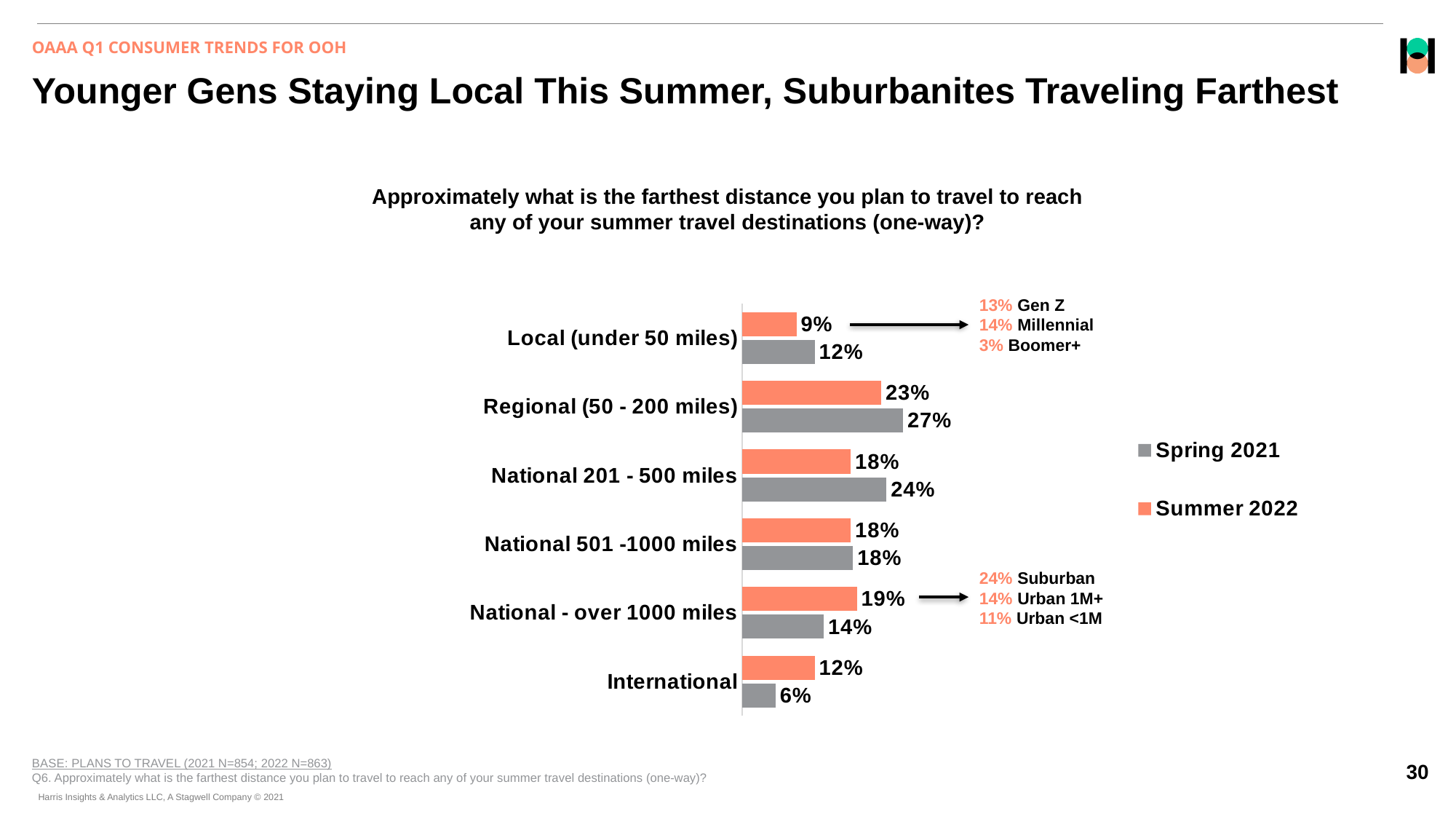
What is the difference between the Spring 2021 and Summer 2022 values for National 201 - 500 miles? 6% How many series does the legend list? 2 How many distance categories are shown in the chart? 6 What kind of chart is shown on the slide? Bar chart Which category has the lowest Spring 2021 value? International What is the Spring 2021 value for Regional (50 - 200 miles)? 27% What is the Summer 2022 value for Local (under 50 miles)? 9% Which category has the highest Summer 2022 value? Regional (50 - 200 miles) For National - over 1000 miles, which series has the larger value, Spring 2021 or Summer 2022? Summer 2022 What is the difference between the Summer 2022 and Spring 2021 values for International? 6% What is the Spring 2021 value for International? 6% Which colour represents Summer 2022 in the chart? Orange